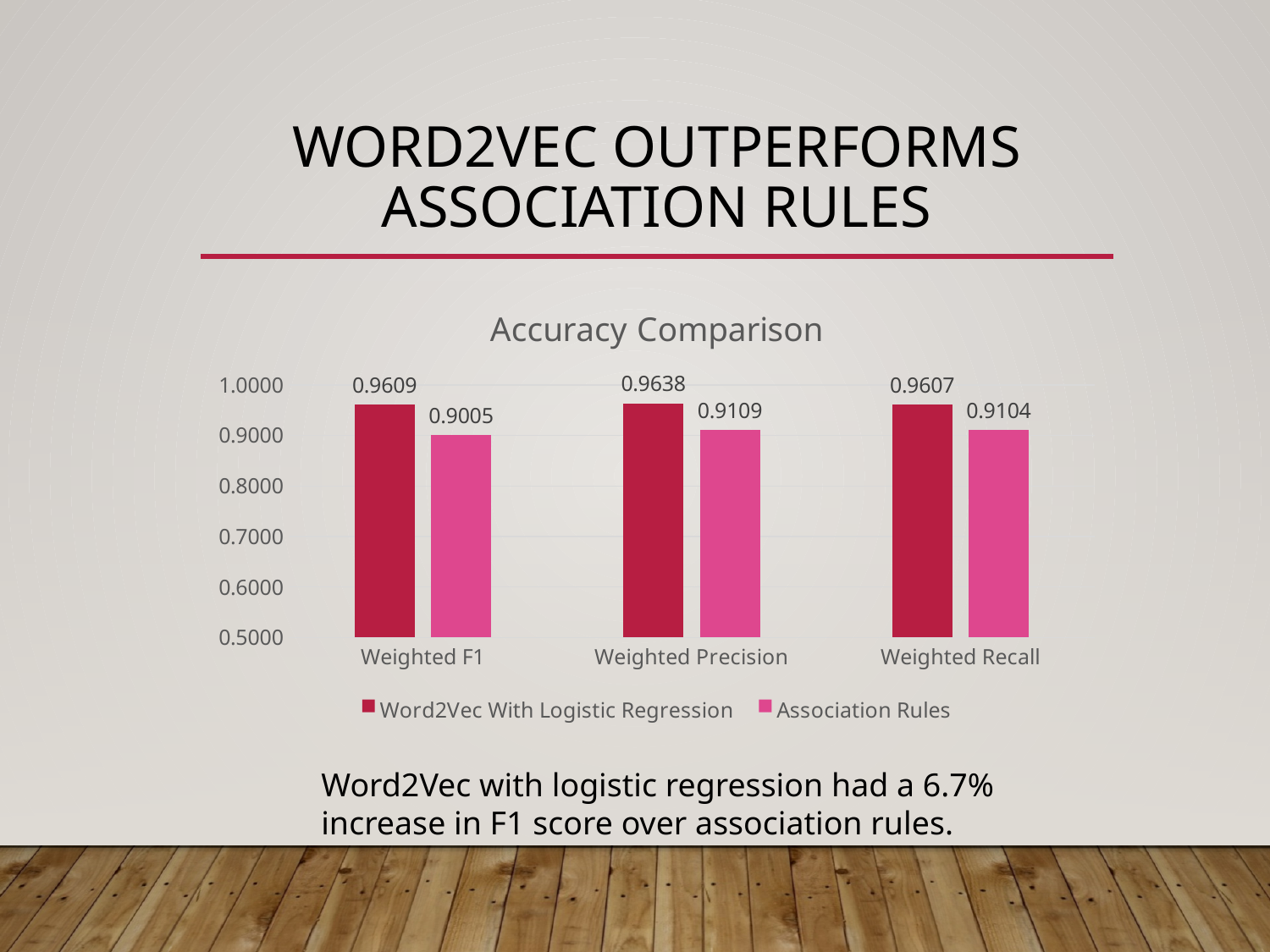
What is the Weighted Precision value for Association Rules? 0.9109 What is the title of the chart? Accuracy Comparison Which metric has the highest value for Word2Vec With Logistic Regression? Weighted Precision What is the Weighted Recall value for Word2Vec With Logistic Regression? 0.9607 What is the Weighted F1 value for Word2Vec With Logistic Regression? 0.9609 How many categories are shown on the x axis? 3 Which metric has the lowest value for Association Rules? Weighted F1 What is the Weighted F1 value for Association Rules? 0.9005 What kind of chart is shown on the slide? Bar chart What is the difference between the Weighted F1 values of Word2Vec With Logistic Regression and Association Rules? 0.0604 For Weighted Recall, which series has the larger value: Word2Vec With Logistic Regression or Association Rules? Word2Vec With Logistic Regression How many series does the legend list? 2